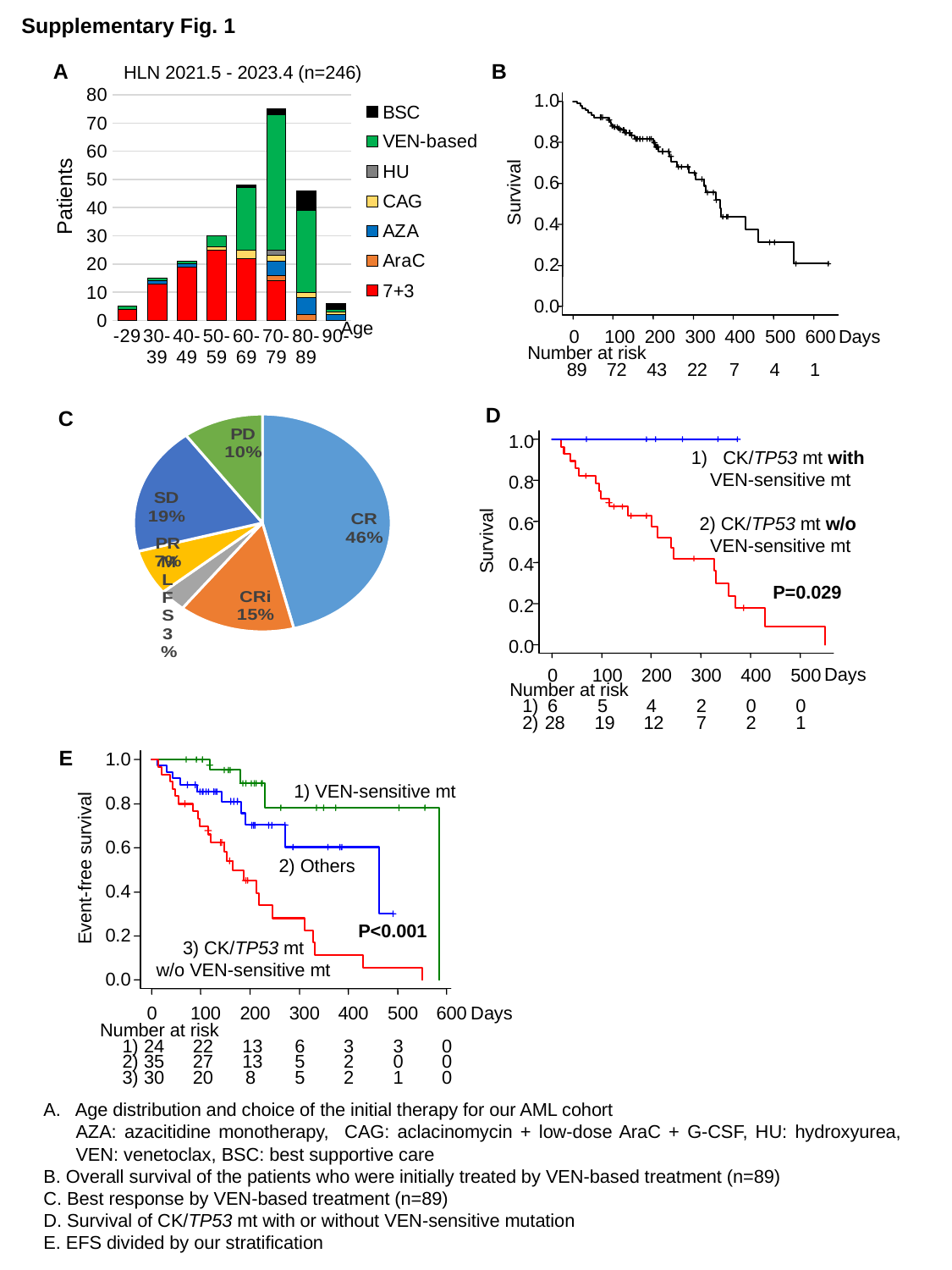
In panel C, what is the difference between the CR share and the CRi share? 31% In panel B, what is the number at risk at 200 days? 43 In panel C, which response category has the smallest slice? MLFS In panel D, what is the number at risk for group 2) at 100 days? 19 In panel A, how many age categories are shown on the x axis? 8 In panel E, what P value is shown? P<0.001 In panel A, how many series does the legend list? 7 In panel C, what share of the pie is CR? 46% In panel A, is the total number of patients in the 70-79 age group greater or less than 70? greater What kind of chart is panel C? pie chart In panel A, which age group has the highest number of patients? 70-79